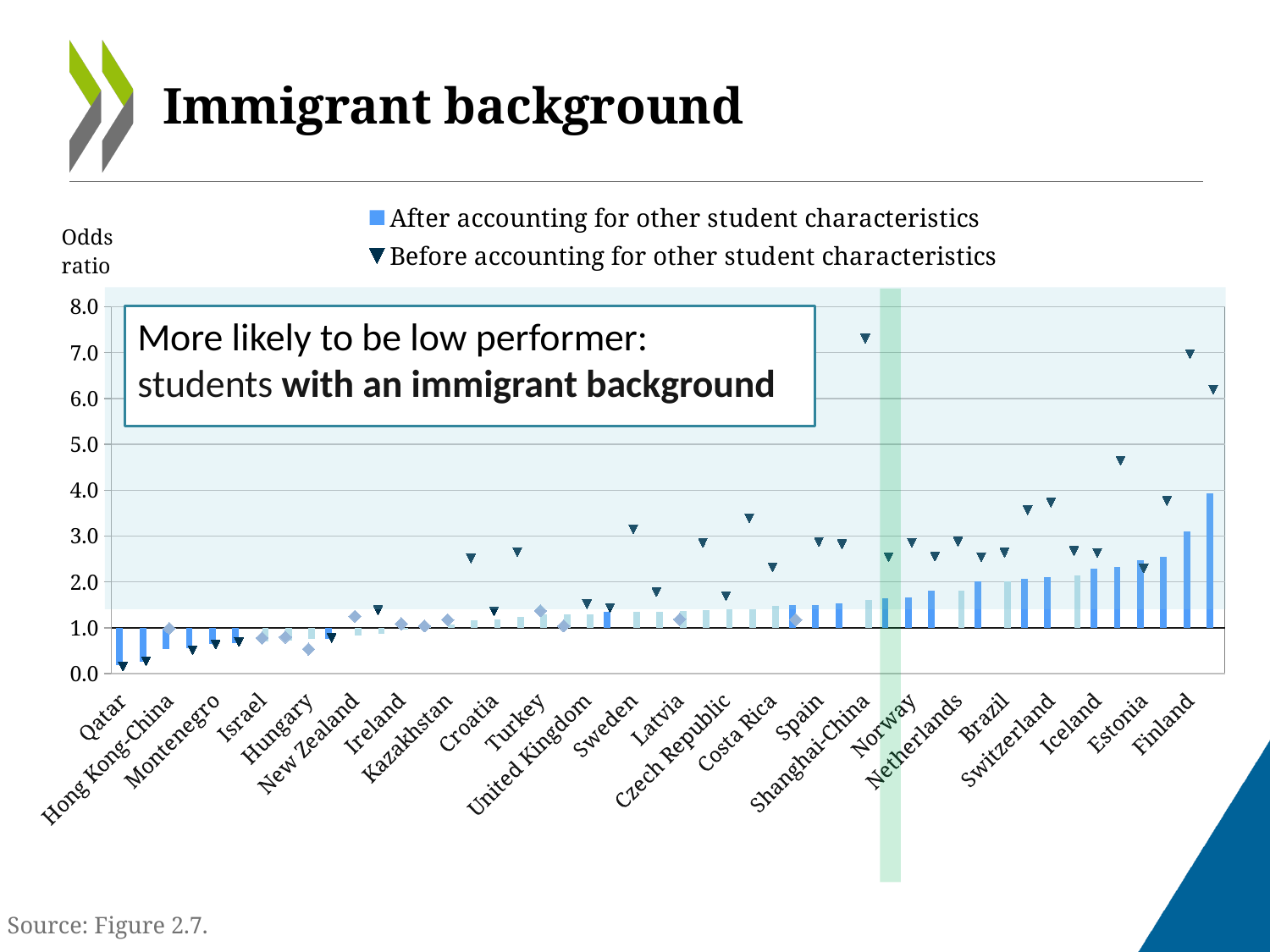
Is the 'Before accounting for other student characteristics' value for Norway greater or less than 2.0? greater What is the label on the vertical axis of the chart? Odds ratio Is the 'After accounting for other student characteristics' value for Qatar greater or less than 1.0? less Is the 'After accounting for other student characteristics' value for Norway greater or less than 1.0? greater How many series does the legend list? 2 Do the 'After accounting for other student characteristics' bars generally rise or fall from left to right along the x axis? rise Which country has the larger 'After accounting for other student characteristics' value, Qatar or Finland? Finland What kind of chart is shown on the slide? combination bar and line chart (bars with triangle markers) Which is larger for Finland: the value before accounting for other student characteristics or the value after? before accounting for other student characteristics